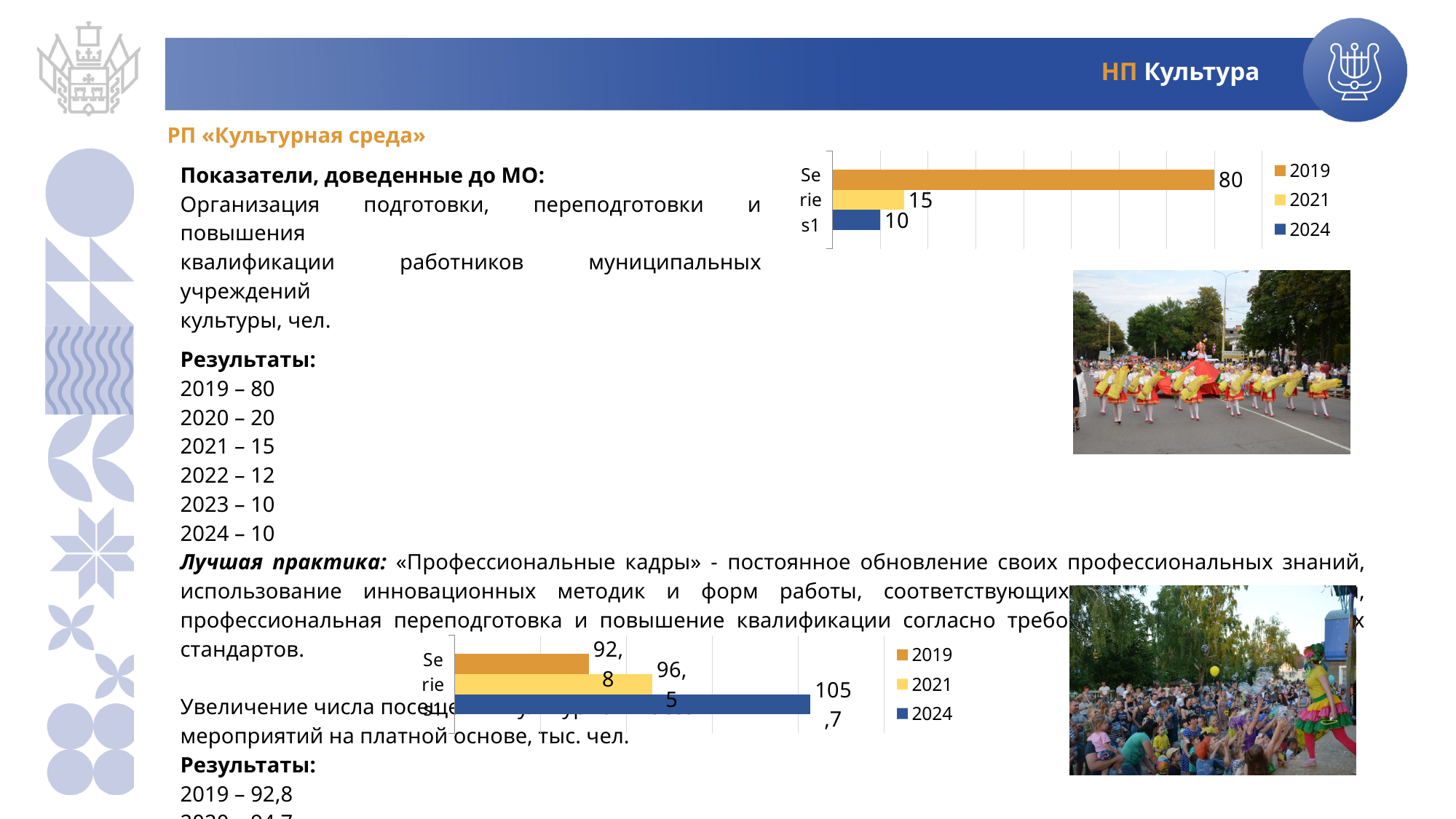
In the bottom chart, what colour is the bar for 2024? blue In the bottom chart, which is larger, the value for 2021 or the value for 2019? 2021 In the bottom chart, which series has the highest value? 2024 In the bottom chart, what is the value for 2024? 105,7 In the top-right chart, what is the difference between the 2019 and 2021 values? 65 In the bottom chart, what is the value for 2019? 92,8 In the top-right chart, what is the value for 2024? 10 In the top-right chart, which series has the highest value? 2019 In the top-right chart, how many series does the legend list? 3 What kind of chart is the top-right chart? bar chart In the top-right chart, which series has the lowest value? 2024 In the top-right chart, what is the value for 2019? 80